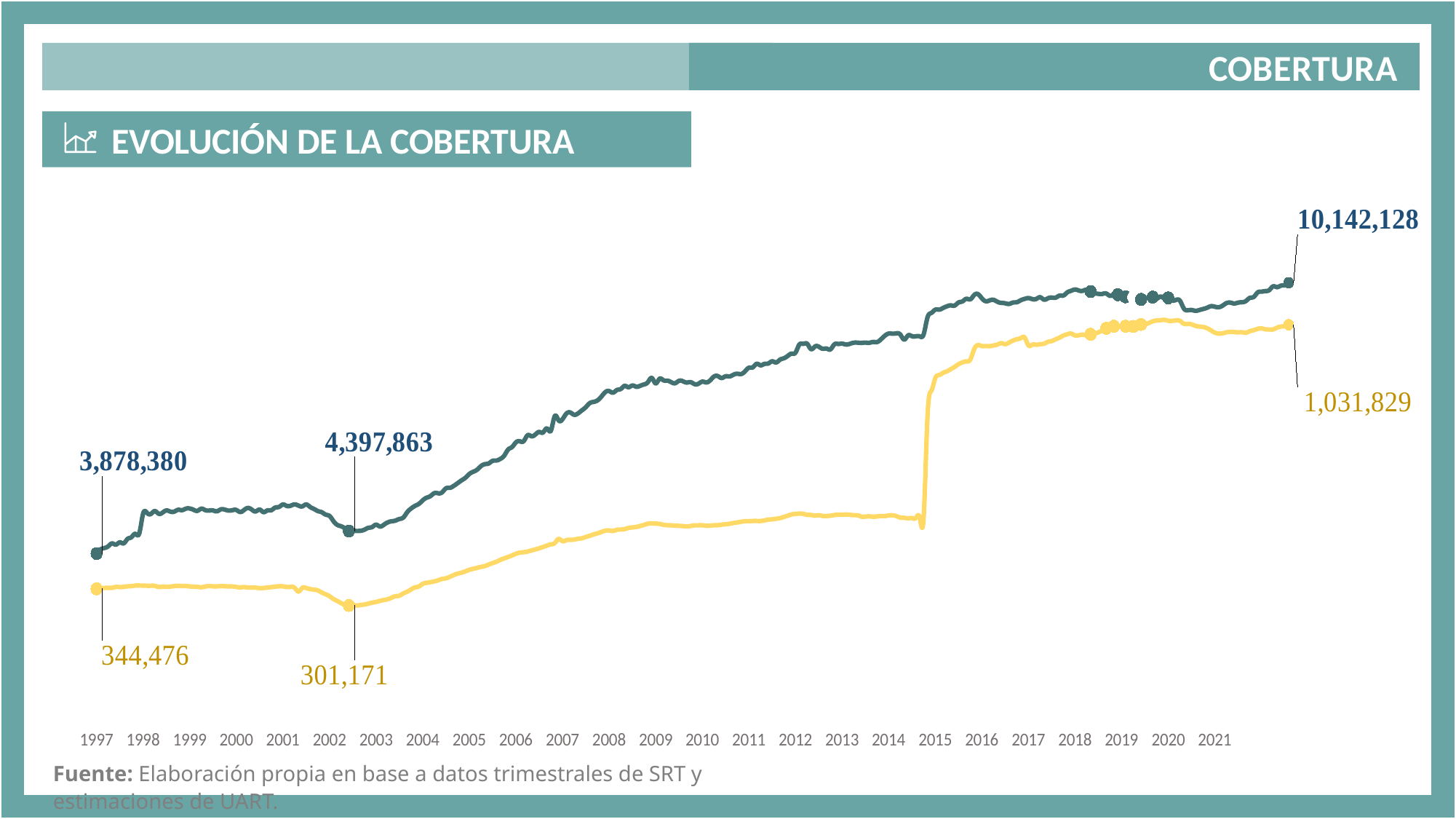
What is the last labelled value of the yellow line, at the right end of the chart? 1,031,829 What is the labelled value of the yellow line at its dip around 2002? 301,171 What kind of chart is shown on the slide? line chart What is the difference between the yellow line's 1997 value (344,476) and its 2002 value (301,171)? 43,305 By how much does the dark teal line's final labelled value (10,142,128) exceed its first labelled value (3,878,380)? 6,263,748 What is the first labelled value of the yellow line, at 1997? 344,476 Which line is higher across the whole chart, the dark teal line or the yellow line? the dark teal line What is the title of the chart? EVOLUCIÓN DE LA COBERTURA What is the first labelled value of the dark teal line, at 1997? 3,878,380 What is the last labelled value of the dark teal line, at the right end of the chart? 10,142,128 What is the labelled value of the dark teal line at its dip around 2002? 4,397,863 How many lines are plotted on the chart? 2